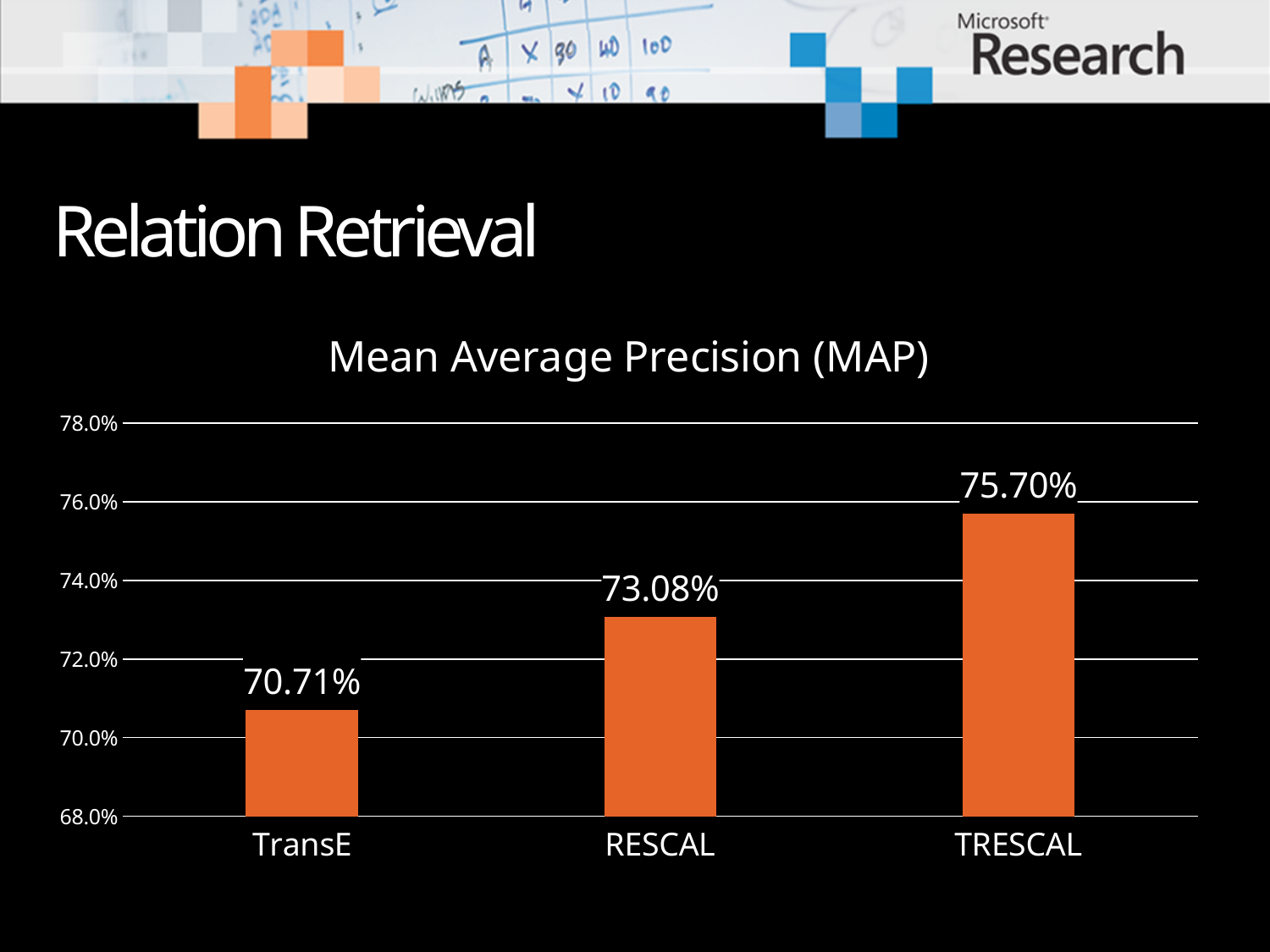
What is the MAP value for RESCAL? 73.08% Which has a higher MAP, RESCAL or TransE? RESCAL What is the difference in MAP between TRESCAL and RESCAL? 2.62% Which method has the highest MAP? TRESCAL How many methods are compared in the chart? 3 What is the MAP value for TransE? 70.71% What is the difference in MAP between RESCAL and TransE? 2.37% What is the MAP value for TRESCAL? 75.70% Is the MAP value for TRESCAL greater or less than 76.0%? less What kind of chart is shown on the slide? bar chart Which method has the lowest MAP? TransE What is the title of the chart? Mean Average Precision (MAP)